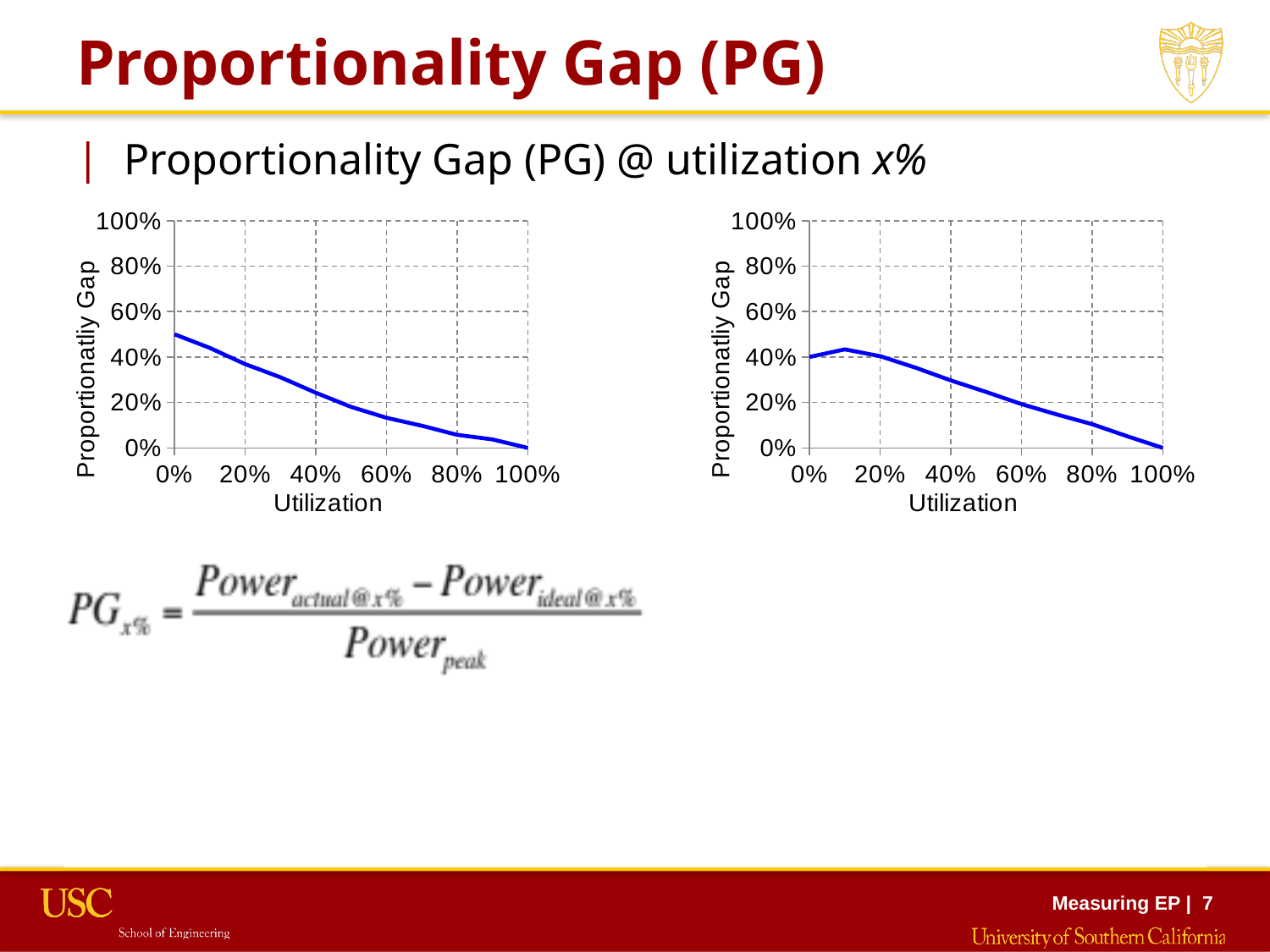
In the left chart, what is the Proportionality Gap at 100% Utilization? 0% In the right chart, does the Proportionality Gap rise or fall as Utilization increases from 20% to 100%? fall What type of chart is the left chart on the slide? line chart In the right chart, what is the Proportionality Gap at 100% Utilization? 0% In the left chart, is the Proportionality Gap at 0% Utilization greater or less than 40%? greater In the right chart, is the Proportionality Gap at 80% Utilization greater or less than 20%? less What type of chart is the right chart on the slide? line chart In the right chart, what is the Proportionality Gap at 0% Utilization? 40% What is the x-axis title of the left chart? Utilization In the right chart, is the Proportionality Gap at 40% Utilization greater or less than 20%? greater In the left chart, does the Proportionality Gap rise or fall as Utilization increases from 0% to 100%? fall